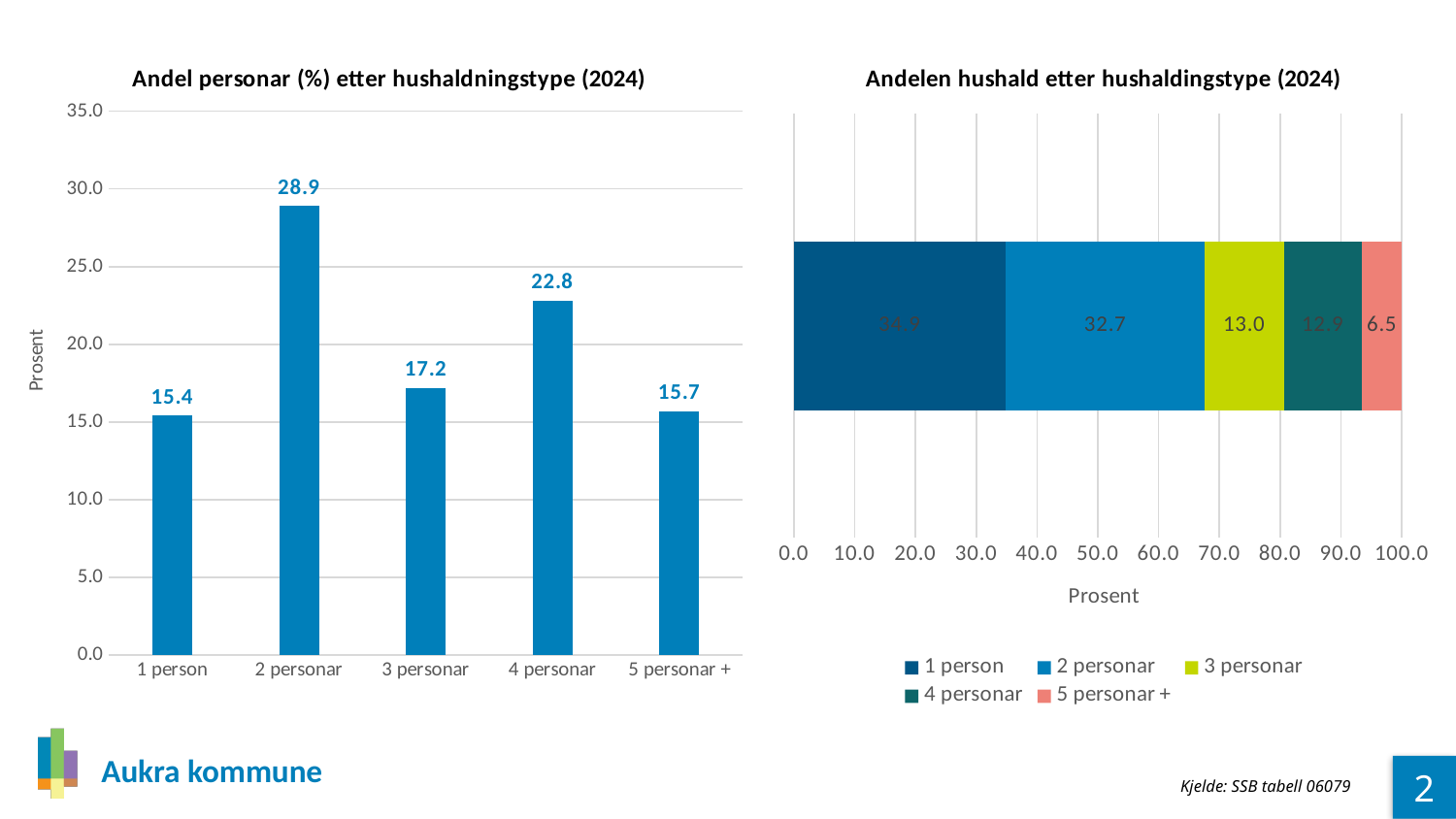
What kind of chart is 'Andel personar (%) etter hushaldningstype (2024)'? Bar chart In the chart 'Andelen hushald etter hushaldingstype (2024)', what is the value for 5 personar +? 6.5 In the chart 'Andel personar (%) etter hushaldningstype (2024)', what is the value for 2 personar? 28.9 In the chart 'Andel personar (%) etter hushaldningstype (2024)', which category has the highest value? 2 personar How many categories are shown on the x axis of the chart 'Andel personar (%) etter hushaldningstype (2024)'? 5 How many series does the legend of the chart 'Andelen hushald etter hushaldingstype (2024)' list? 5 In the chart 'Andel personar (%) etter hushaldningstype (2024)', which category has the lowest value? 1 person In the chart 'Andelen hushald etter hushaldingstype (2024)', which is larger: the segment for 2 personar or the segment for 3 personar? 2 personar In the chart 'Andel personar (%) etter hushaldningstype (2024)', which is larger: the value for 3 personar or the value for 5 personar +? 3 personar In the chart 'Andel personar (%) etter hushaldningstype (2024)', what is the difference between the values for 2 personar and 3 personar? 11.7 In the chart 'Andelen hushald etter hushaldingstype (2024)', what is the value for 2 personar? 32.7 In the chart 'Andel personar (%) etter hushaldningstype (2024)', what is the value for 4 personar? 22.8